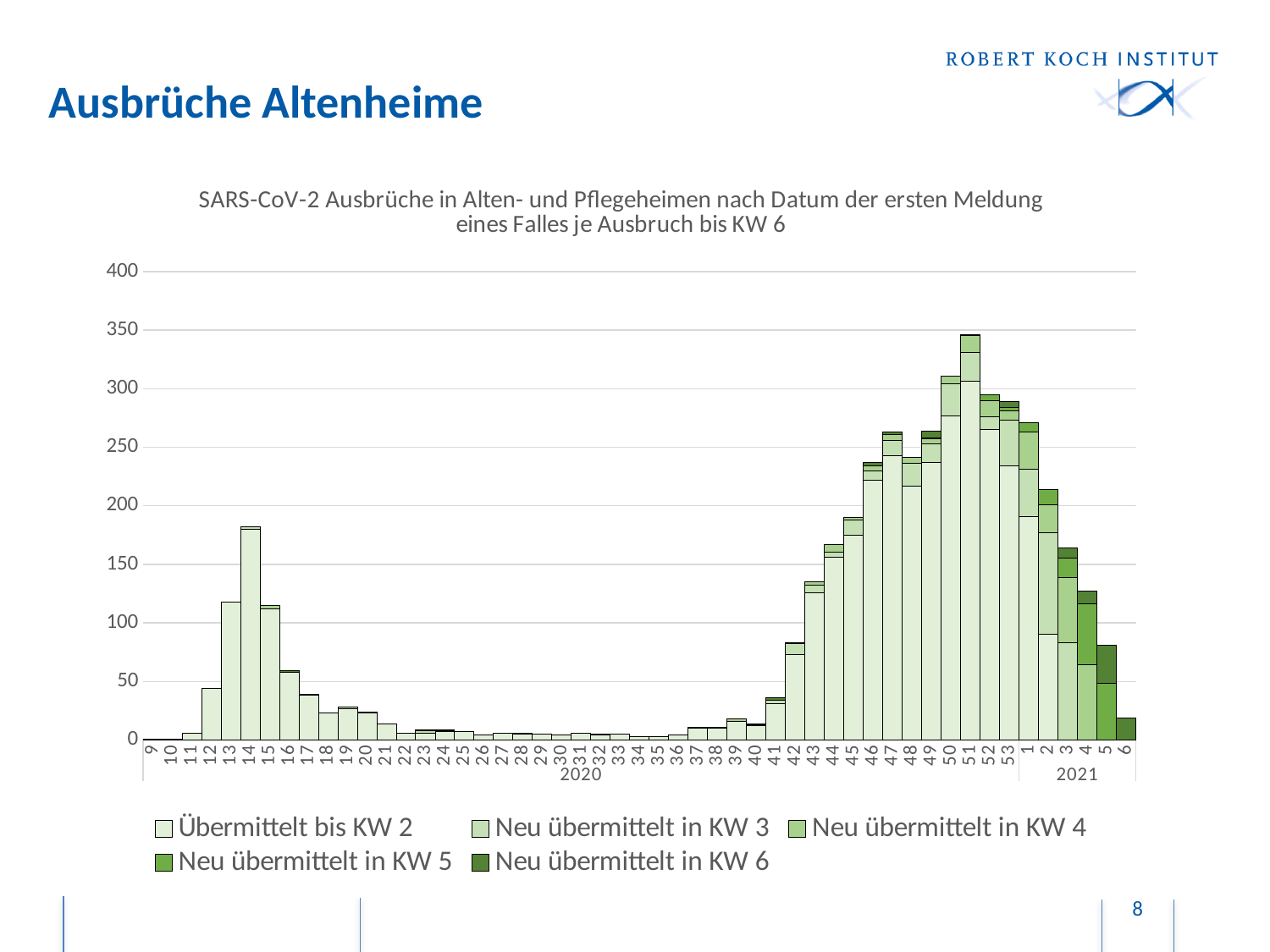
Which calendar week has the highest total number of outbreaks? KW 51 (2020) Do the totals rise or fall from KW 42 to KW 51 of 2020? rise What kind of chart is shown on the slide? bar chart Is the value for KW 30 of 2020 greater or less than 50? less Which is larger, the total for KW 13 or KW 16 of 2020? KW 13 Is the total value for KW 51 of 2020 greater or less than 300? greater Which is larger, the value for KW 14 or KW 15 of 2020? KW 14 Is the total value for KW 6 of 2021 greater or less than 50? less How many series does the legend list? 5 What is the first entry in the legend? Übermittelt bis KW 2